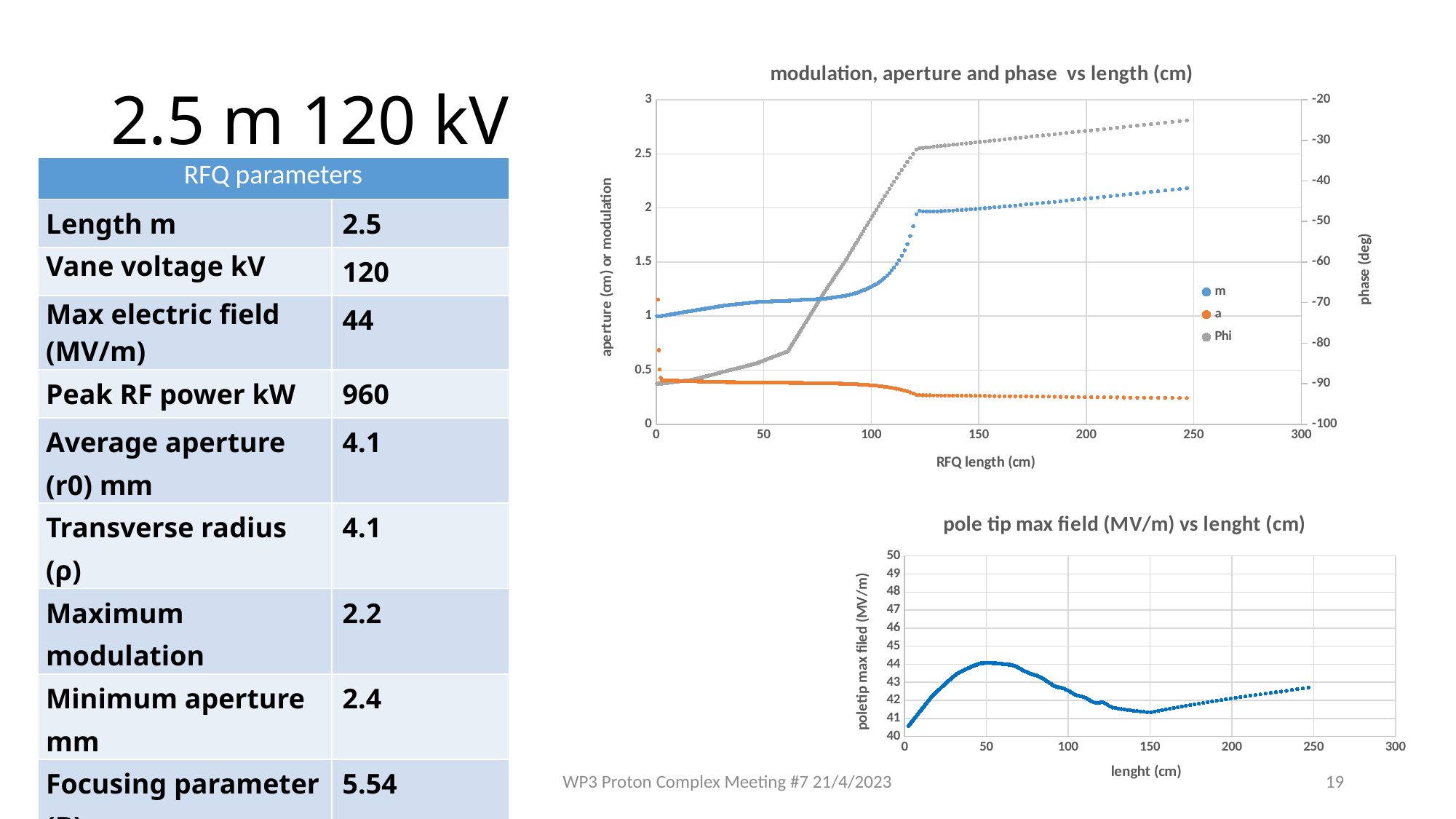
In the chart titled 'modulation, aperture and phase vs length (cm)', how many series does the legend list? 3 In the chart titled 'modulation, aperture and phase vs length (cm)', is the value of the m series at 250 cm greater or less than 2? greater In the chart titled 'modulation, aperture and phase vs length (cm)', what is the label of the right-hand vertical axis? phase (deg) In the chart titled 'modulation, aperture and phase vs length (cm)', is the value of the a series at 200 cm greater or less than 0.5? less What kind of chart is the one titled 'pole tip max field (MV/m) vs lenght (cm)'? scatter chart In the chart titled 'modulation, aperture and phase vs length (cm)', does the m series rise or fall as RFQ length increases? rise In the chart titled 'pole tip max field (MV/m) vs lenght (cm)', is the value at 150 cm greater or less than 42? less In the chart titled 'modulation, aperture and phase vs length (cm)', does the a series rise or fall as RFQ length increases? fall In the chart titled 'modulation, aperture and phase vs length (cm)', what are the names of the series in the legend? m, a, Phi In the chart titled 'pole tip max field (MV/m) vs lenght (cm)', does the value rise or fall between 0 and 50 cm? rise